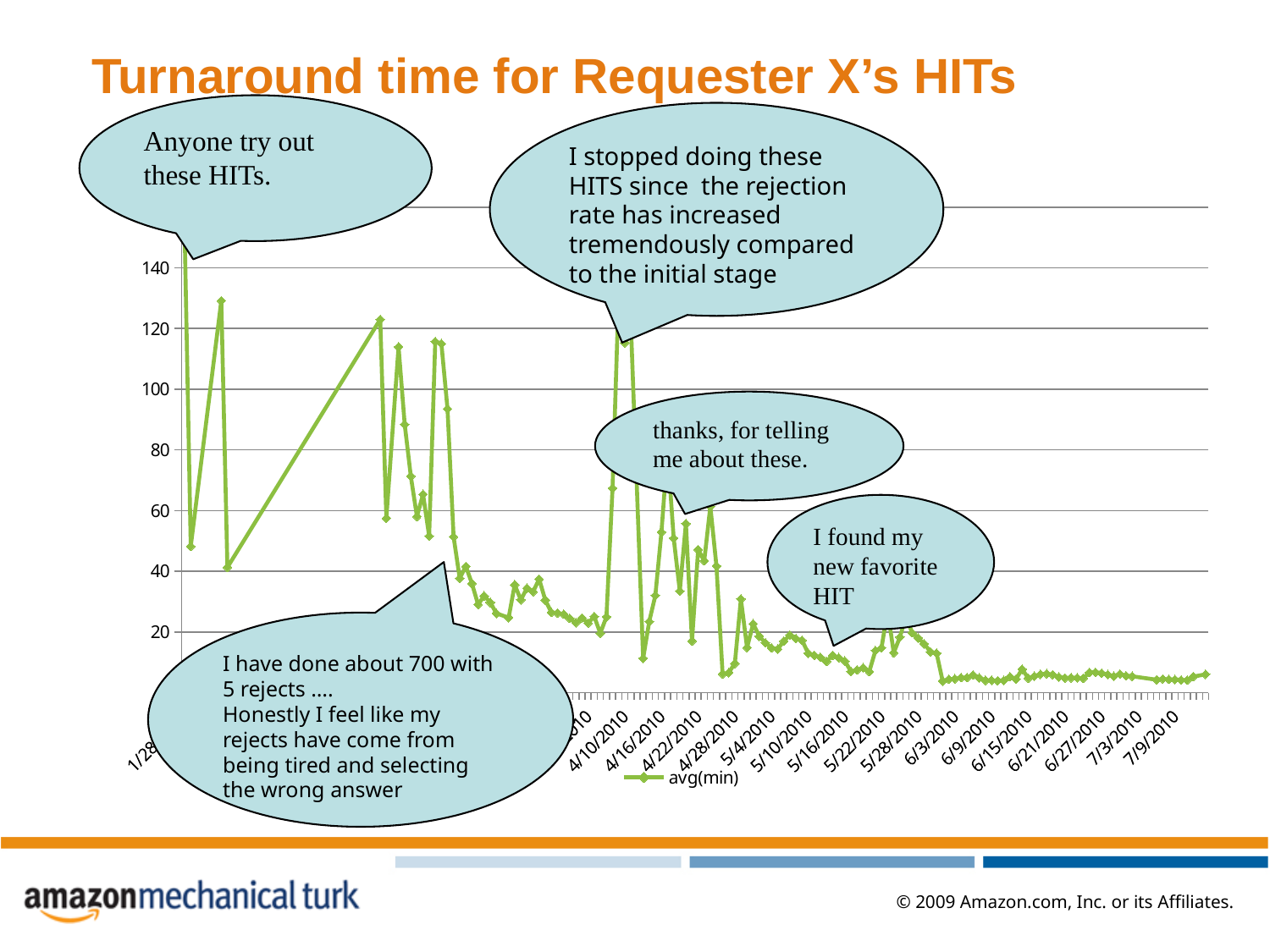
Which is larger, the value at the start of the series (1/28) or the value at the end of the series (7/9/2010)? 1/28 What is the name of the series shown in the chart's legend? avg(min) Is the value for 7/9/2010 greater or less than 20? less Is the highest plotted value on the chart greater or less than 140? greater What kind of chart is shown on the slide? line chart What is the title of the slide's chart? Turnaround time for Requester X's HITs Do the avg(min) values generally rise or fall from left to right along the x axis? fall Is the value for 6/21/2010 greater or less than 40? less How many series does the chart's legend list? 1